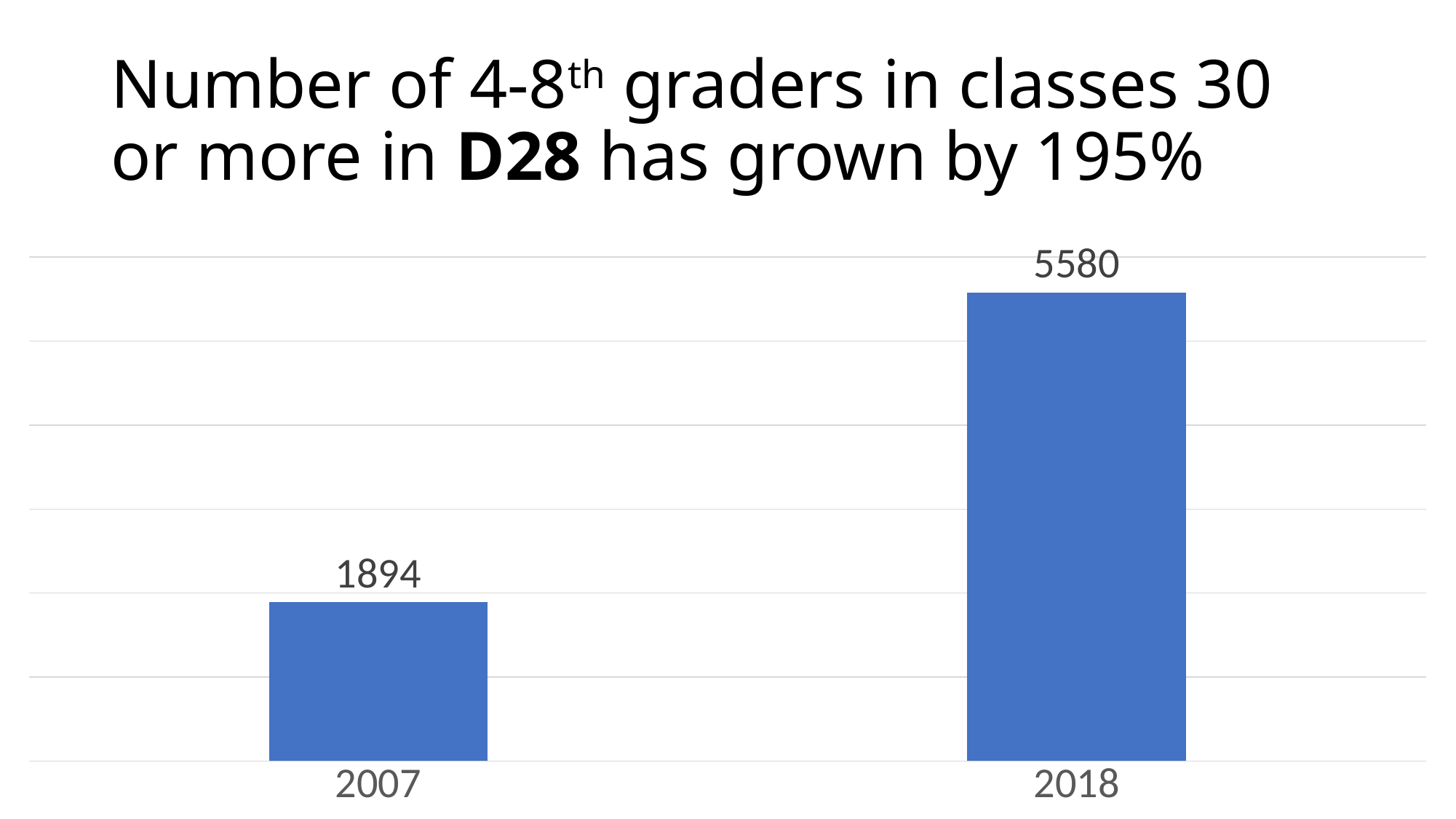
Do the values rise or fall from 2007 to 2018? Rise What is the value for 2018? 5580 What is the value for 2007? 1894 What kind of chart is shown on the slide? Bar chart What is the total of the two bars? 7474 Is the value for 2018 larger than the value for 2007? Yes What is the difference between the values for 2018 and 2007? 3686 Which year has the higher value? 2018 What colour are the bars in the chart? Blue By what percentage does the slide title say the number has grown? 195% How many bars are shown in the chart? 2 Which year has the lower value? 2007